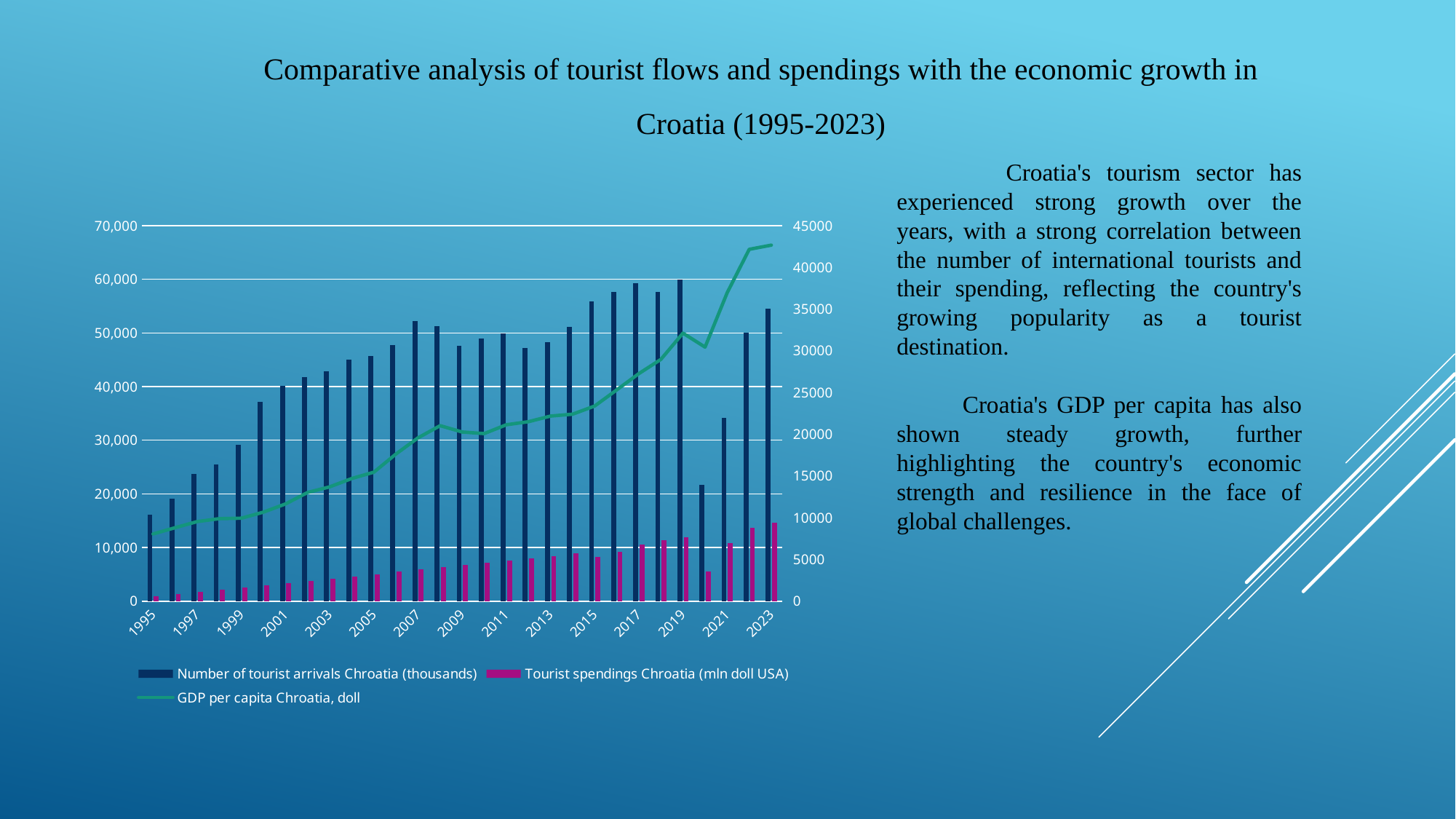
What colour is the line for GDP per capita Chroatia, doll? Green What kind of chart is shown on the slide? A combination chart of bars and a line How many years are plotted along the x axis of the chart? 29 Which year has more tourist arrivals, 2019 or 2020? 2019 Is the number of tourist arrivals in 2019 greater or less than 50,000? greater Which year has the lowest tourist spendings in Croatia? 1995 Which year has the lowest number of tourist arrivals in Croatia? 1995 Is the GDP per capita of Croatia in 2023 greater or less than 40000 on the right axis? greater How many series does the chart legend list? 3 Is the number of tourist arrivals in 2020 greater or less than 30,000? less Which year has more tourist arrivals, 2021 or 2022? 2022 Does the GDP per capita line generally rise or fall from 1995 to 2023? rise